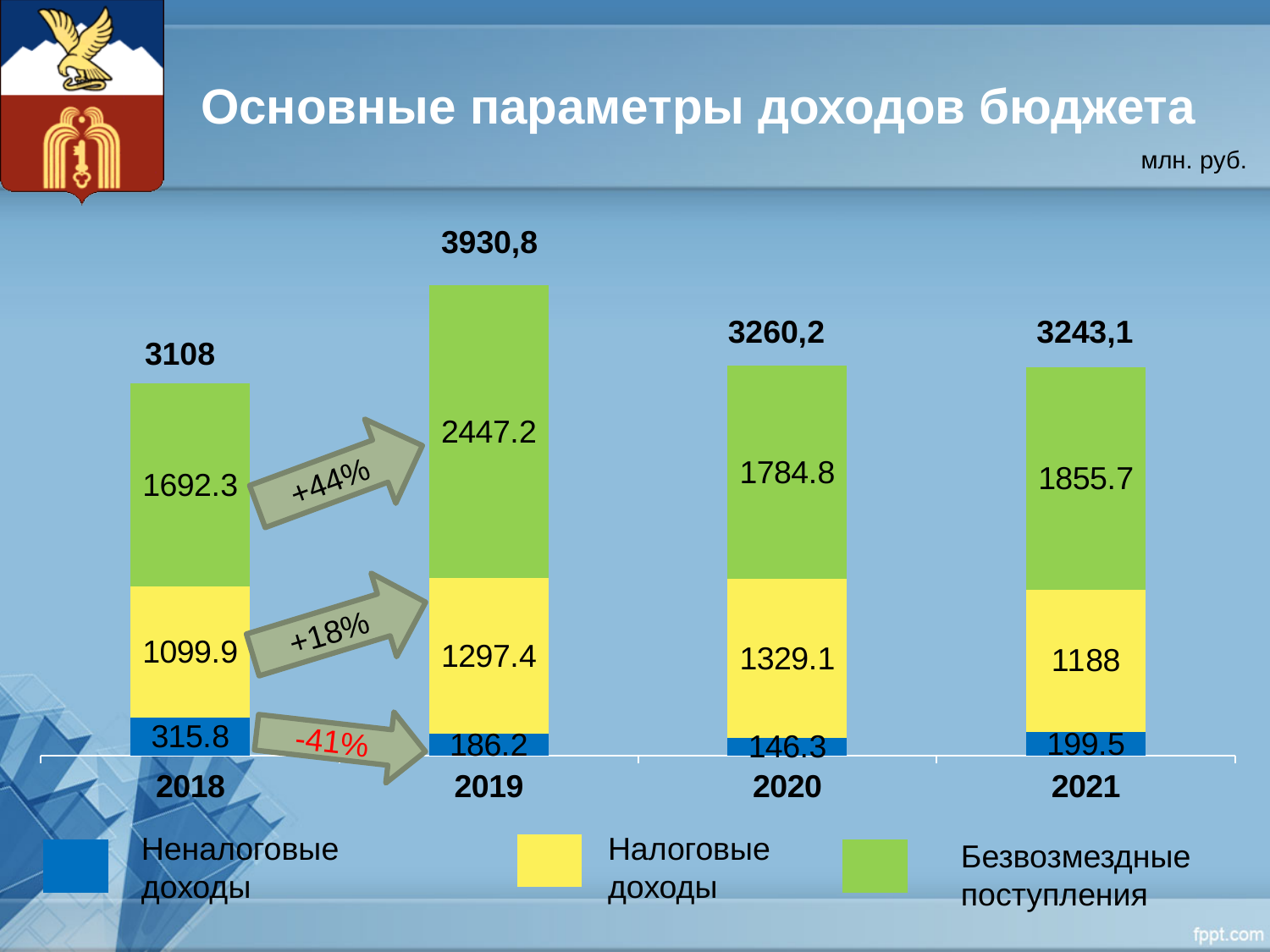
Which is larger: Безвозмездные поступления in 2020 or in 2021? 2021 What type of chart is shown on the slide? Stacked bar chart How many years are shown on the x axis? 4 What is the value of Безвозмездные поступления in 2019? 2447.2 What colour represents Налоговые доходы in the chart? Yellow Which year has the highest total budget revenue? 2019 What is the value of Неналоговые доходы in 2020? 146.3 What is the difference between Налоговые доходы in 2020 and in 2018? 229.2 How many series does the legend list? 3 What is the total of the stacked bar for 2019? 3930,8 What is the value of Налоговые доходы in 2021? 1188 Which year has the lowest value for Неналоговые доходы? 2020